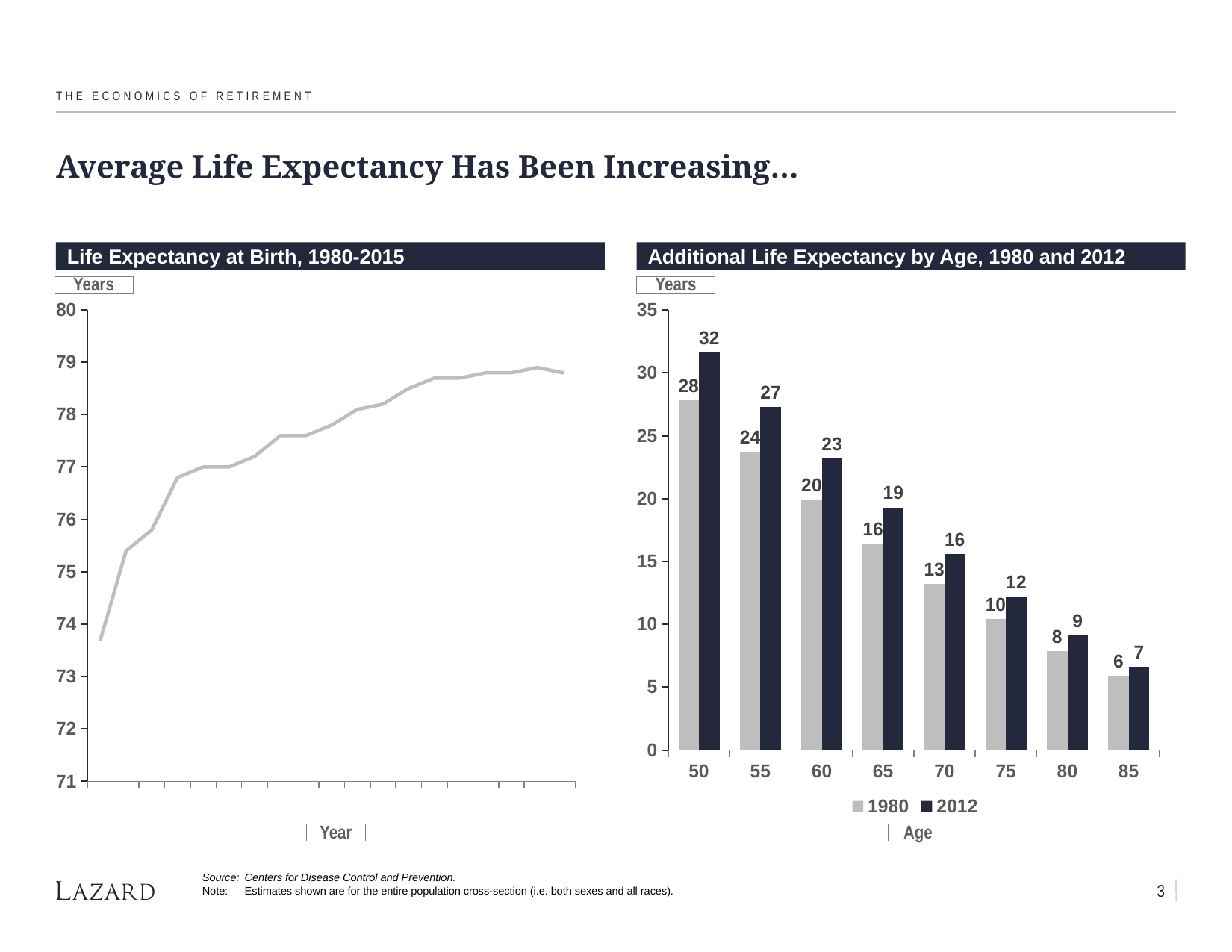
In the chart titled "Additional Life Expectancy by Age, 1980 and 2012", how many series does the legend list? 2 In the chart titled "Additional Life Expectancy by Age, 1980 and 2012", which age has the lowest 1980 value? 85 In the chart titled "Additional Life Expectancy by Age, 1980 and 2012", which is larger for age 65: the 1980 value or the 2012 value? 2012 What kind of chart is the chart titled "Additional Life Expectancy by Age, 1980 and 2012"? Bar chart In the chart titled "Additional Life Expectancy by Age, 1980 and 2012", how many age categories are shown on the x axis? 8 In the chart titled "Additional Life Expectancy by Age, 1980 and 2012", what is the difference between the 2012 and 1980 values for age 60? 3 In the chart titled "Life Expectancy at Birth, 1980-2015", does the line generally rise or fall along the x axis? Rise In the chart titled "Additional Life Expectancy by Age, 1980 and 2012", do the 2012 values rise or fall as age increases along the x axis? Fall What kind of chart is the chart titled "Life Expectancy at Birth, 1980-2015"? Line chart In the chart titled "Additional Life Expectancy by Age, 1980 and 2012", what is the value for age 70 in 1980? 13 In the chart titled "Additional Life Expectancy by Age, 1980 and 2012", which age has the highest 2012 value? 50 In the chart titled "Additional Life Expectancy by Age, 1980 and 2012", what is the value for age 50 in 2012? 32